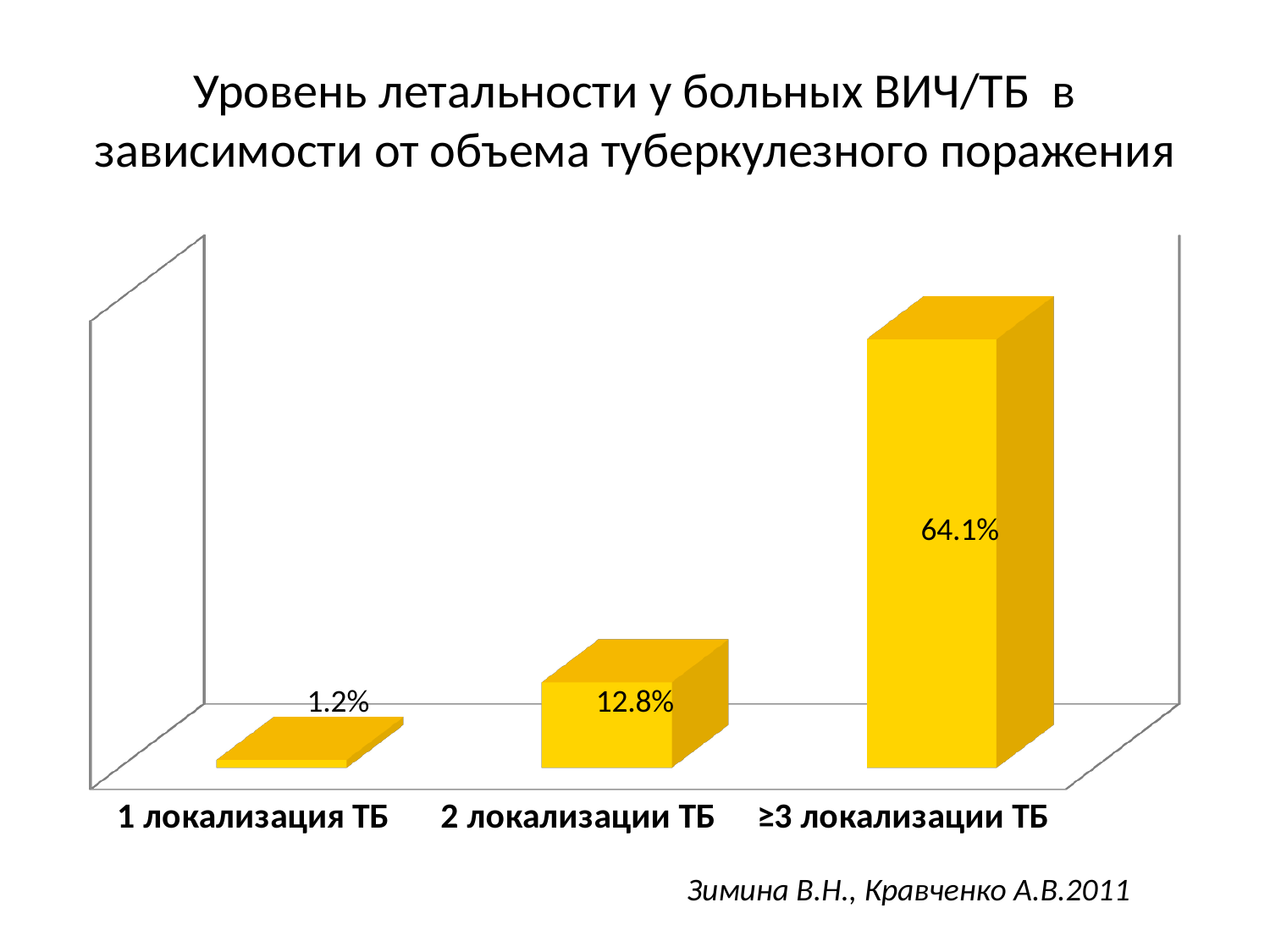
What is the lethality rate for patients with 2 локализации ТБ? 12.8% What kind of chart is shown on the slide? Bar chart What colour are the bars in the chart? Yellow What is the difference between the lethality rates for ≥3 локализации ТБ and 2 локализации ТБ? 51.3% Do the lethality rates rise or fall as the number of TB localizations increases along the x axis? Rise What is the lethality rate for patients with ≥3 локализации ТБ? 64.1% Which category has the highest lethality rate? ≥3 локализации ТБ Which category has the lowest lethality rate? 1 локализация ТБ How many categories are shown on the chart? 3 What is the difference between the lethality rates for 2 локализации ТБ and 1 локализация ТБ? 11.6% What is the lethality rate for patients with 1 локализация ТБ? 1.2% Which is larger: the lethality rate for 2 локализации ТБ or for 1 локализация ТБ? 2 локализации ТБ